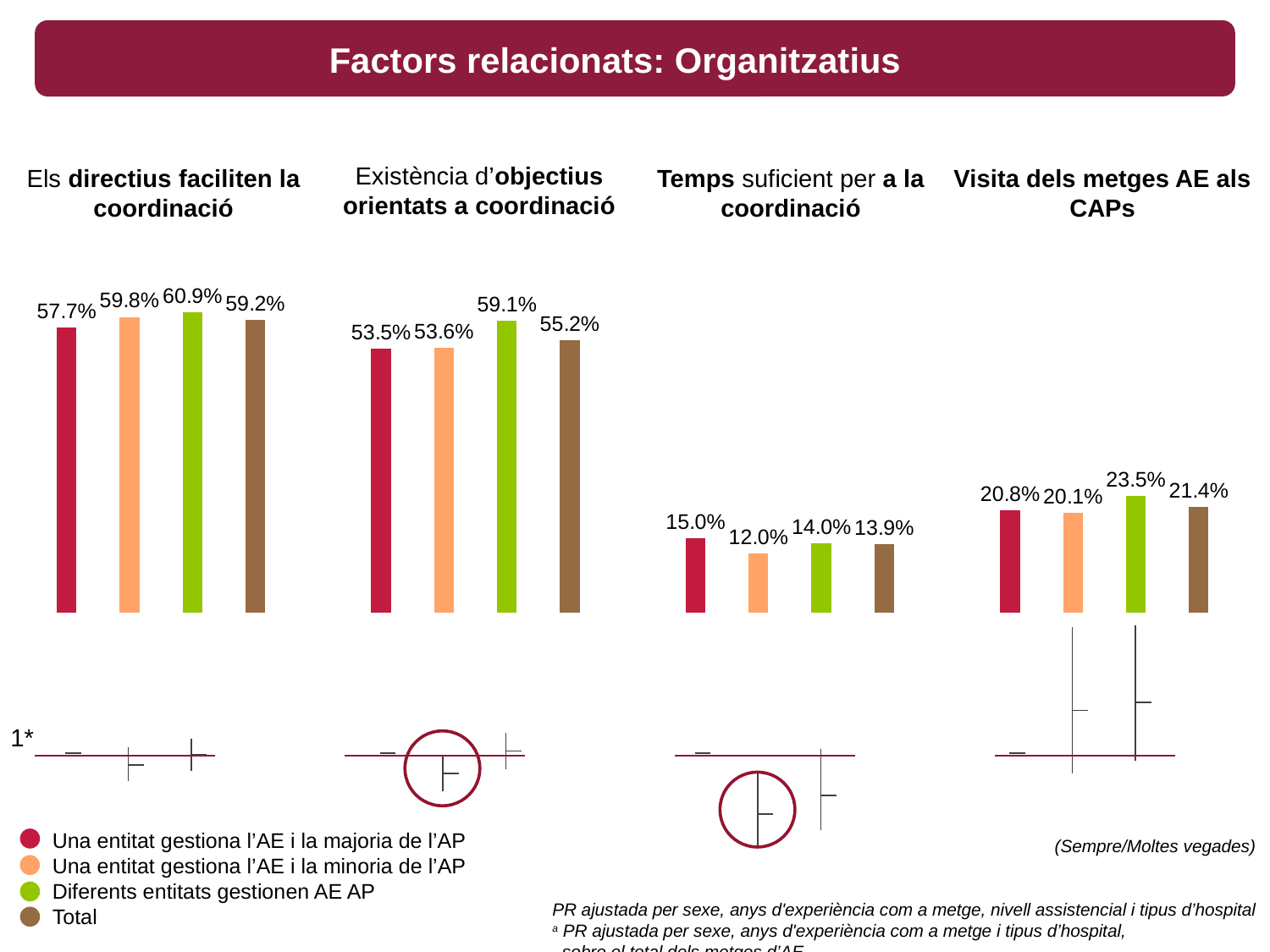
In the chart 'Existència d'objectius orientats a coordinació', what is the difference between 'Diferents entitats gestionen AE AP' and 'Una entitat gestiona l'AE i la majoria de l'AP'? 5.6% How many bars are shown in the chart 'Temps suficient per a la coordinació'? 4 In the chart 'Visita dels metges AE als CAPs', what is the difference between 'Diferents entitats gestionen AE AP' and 'Una entitat gestiona l'AE i la minoria de l'AP'? 3.4% How many series does the legend list? 4 In the chart 'Temps suficient per a la coordinació', which series has the lowest value? Una entitat gestiona l'AE i la minoria de l'AP In the chart 'Els directius faciliten la coordinació', what is the value for 'Una entitat gestiona l'AE i la majoria de l'AP'? 57.7% In the chart 'Visita dels metges AE als CAPs', which is larger: 'Una entitat gestiona l'AE i la majoria de l'AP' or 'Diferents entitats gestionen AE AP'? Diferents entitats gestionen AE AP In the chart 'Temps suficient per a la coordinació', what is the value for 'Diferents entitats gestionen AE AP'? 14.0% In the chart 'Els directius faciliten la coordinació', which series has the highest value? Diferents entitats gestionen AE AP In the chart 'Existència d'objectius orientats a coordinació', what is the value for 'Total'? 55.2% What kind of chart is 'Els directius faciliten la coordinació'? Bar chart In the chart 'Visita dels metges AE als CAPs', what is the value for 'Total'? 21.4%